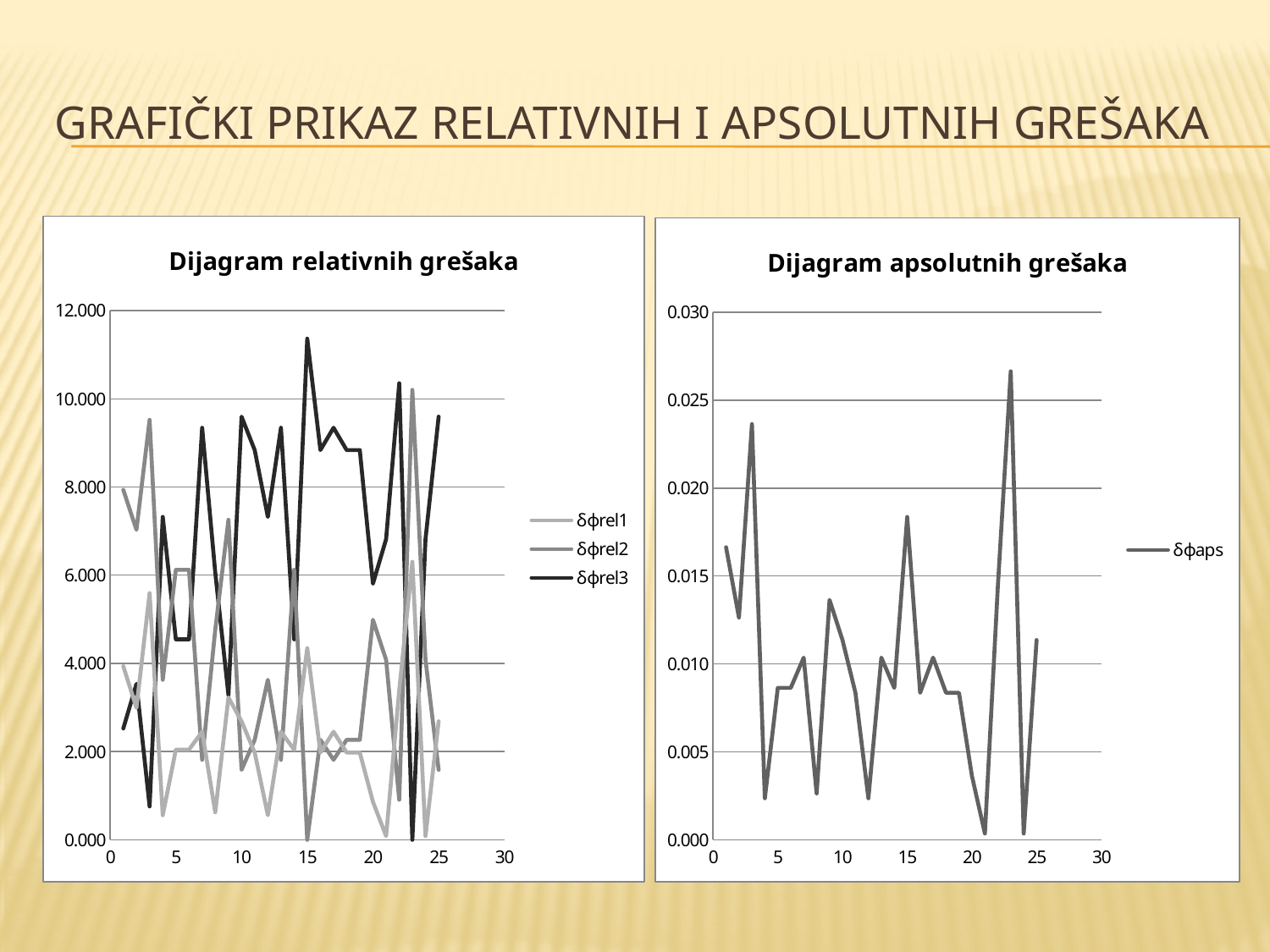
How many series does the legend of the 'Dijagram apsolutnih grešaka' chart list? 1 In the 'Dijagram apsolutnih grešaka' chart, at which x value does δφaps reach its highest point? 23 What kind of chart is the 'Dijagram relativnih grešaka' chart? line chart In the 'Dijagram relativnih grešaka' chart, which series is drawn with the black line? δφrel3 In the 'Dijagram apsolutnih grešaka' chart, is the value of δφaps at x = 23 greater or less than 0.025? greater In the 'Dijagram relativnih grešaka' chart, at which x value does δφrel3 reach its highest point? 15 What is the name of the series shown in the 'Dijagram apsolutnih grešaka' chart? δφaps In the 'Dijagram relativnih grešaka' chart, is the value of δφrel3 at x = 3 greater or less than 2.000? less In the 'Dijagram apsolutnih grešaka' chart, is the value of δφaps at x = 21 greater or less than 0.005? less What kind of chart is the 'Dijagram apsolutnih grešaka' chart? line chart How many series does the legend of the 'Dijagram relativnih grešaka' chart list? 3